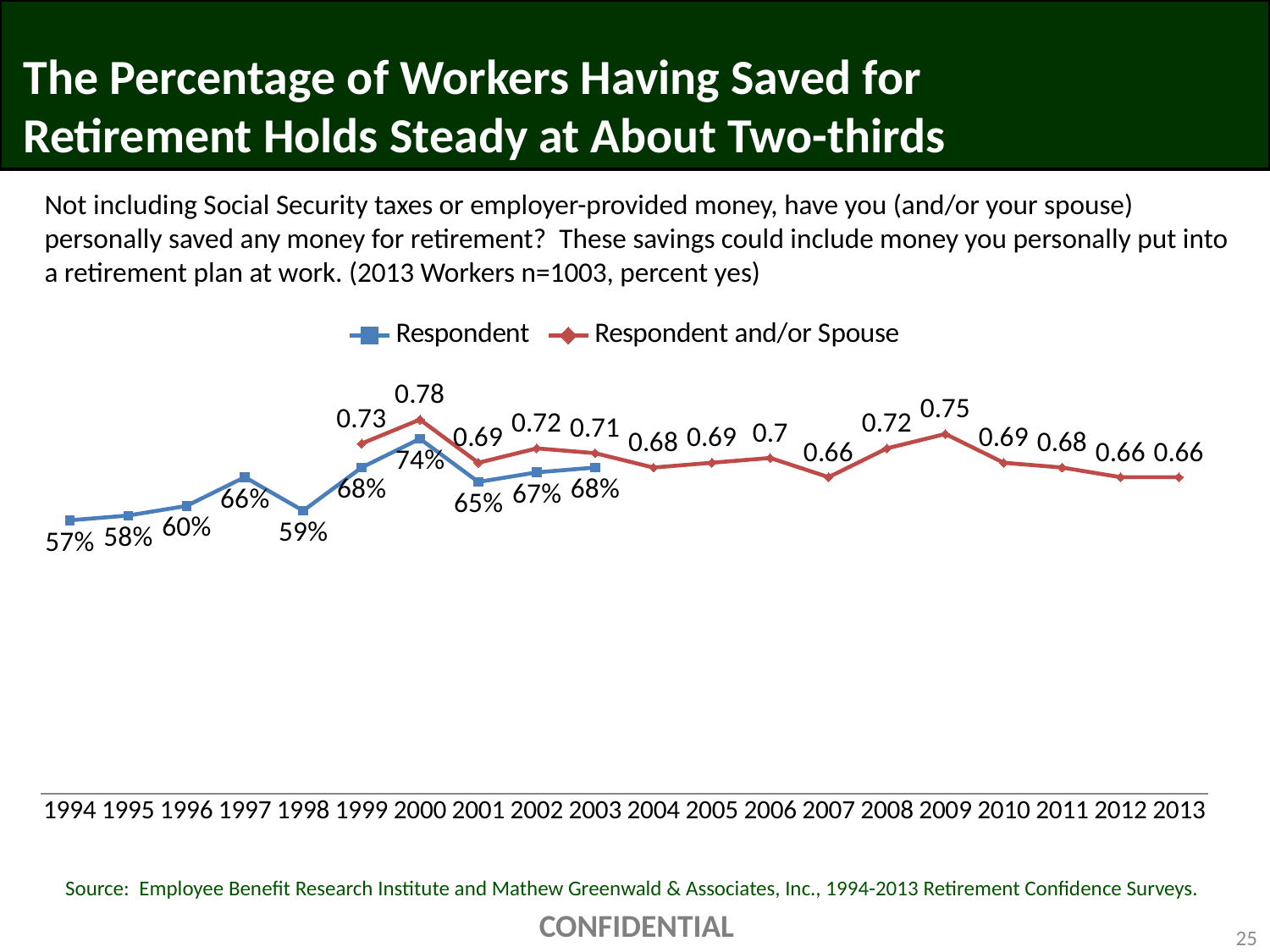
What is the difference between the Respondent value in 2000 and in 1994? 17 percentage points In which year is the Respondent and/or Spouse series highest? 2000 In which year is the Respondent series lowest? 1994 In which year is the Respondent series highest? 2000 What is the value for Respondent and/or Spouse in 2009? 0.75 How many series does the legend list? 2 What is the value for Respondent in 1994? 57% How many years are shown on the x axis? 20 What is the value for Respondent and/or Spouse in 2013? 0.66 What is the lowest value shown for the Respondent and/or Spouse series? 0.66 What kind of chart is shown on the slide? line chart In 2003, which series has the larger value, Respondent or Respondent and/or Spouse? Respondent and/or Spouse